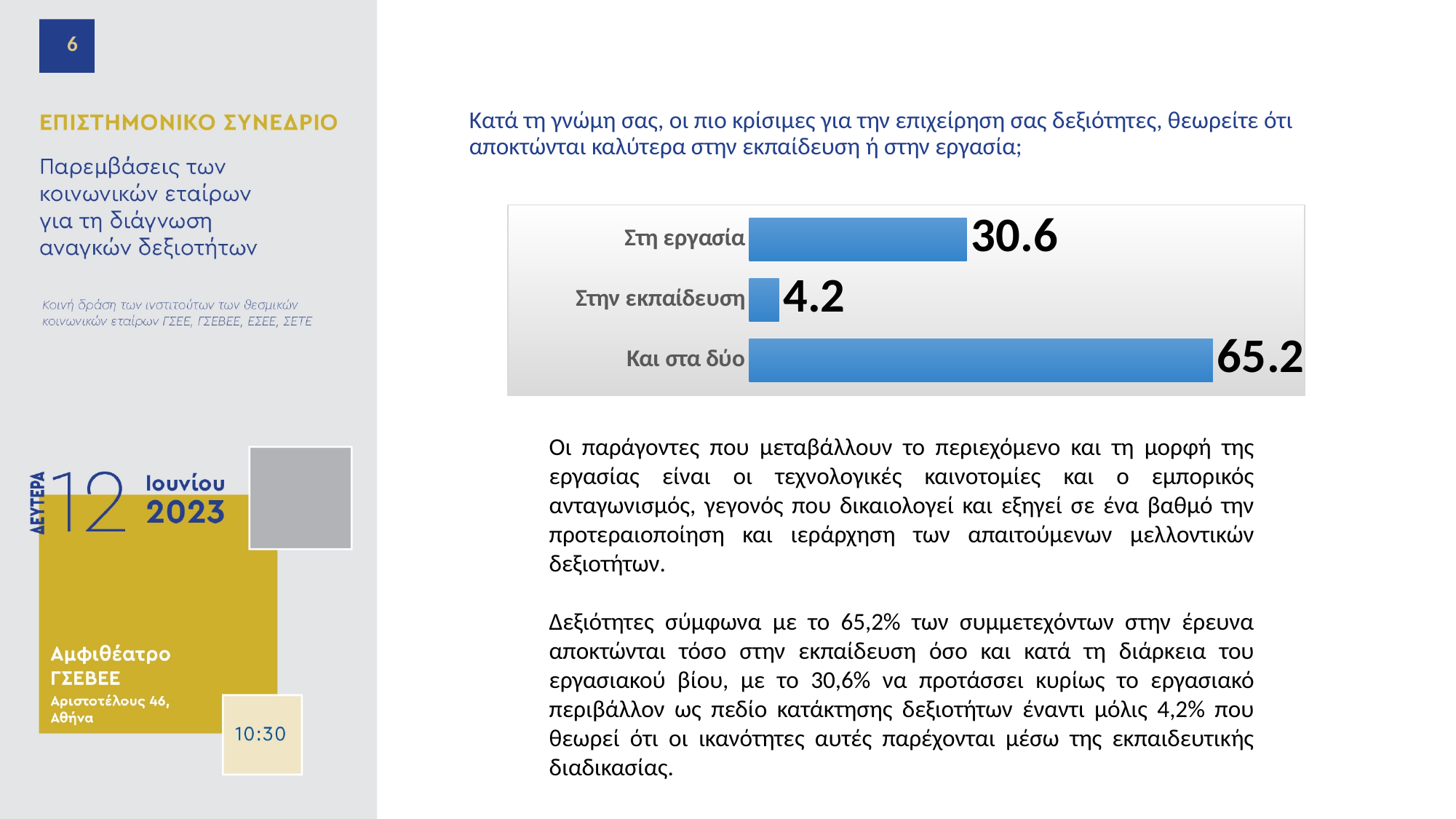
Which category has the lowest value? Στην εκπαίδευση What is the total of the three values shown in the chart? 100 What is the value for 'Στην εκπαίδευση'? 4.2 Which category has the highest value? Και στα δύο How many categories are shown in the chart? 3 What is the difference between the values for 'Στη εργασία' and 'Στην εκπαίδευση'? 26.4 What is the difference between the values for 'Και στα δύο' and 'Στη εργασία'? 34.6 What is the value for 'Και στα δύο'? 65.2 What is the value for 'Στη εργασία'? 30.6 Which is larger, the value for 'Στη εργασία' or the value for 'Στην εκπαίδευση'? Στη εργασία What colour are the bars in the chart? Blue What kind of chart is shown on the slide? Bar chart